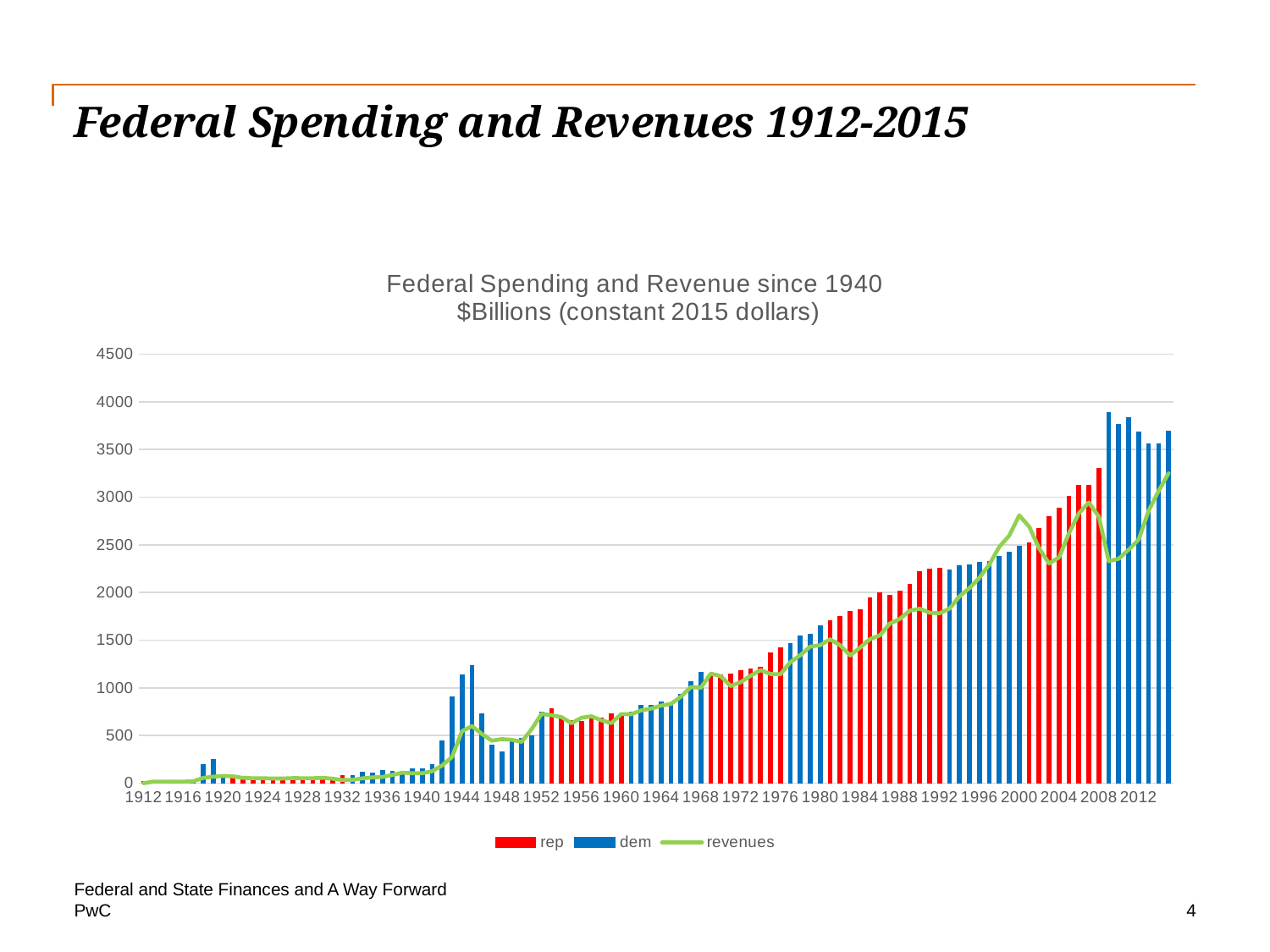
Overall, do federal spending values rise or fall from 1912 to 2015? rise Is the spending bar for 1944 greater or less than 1000? greater Which is larger, the spending bar for 1944 or the spending bar for 1948? 1944 Which series is drawn as a line rather than bars? revenues What kind of chart is shown on the slide? A bar chart combined with a line Which is larger, the spending bar for 2012 or the spending bar for 1992? 2012 Is the spending bar for 1984 greater or less than 1500? greater Is the spending bar for 2008 greater or less than 3000? greater What are the three legend entries of the chart? rep, dem, revenues How many series does the legend list? 3